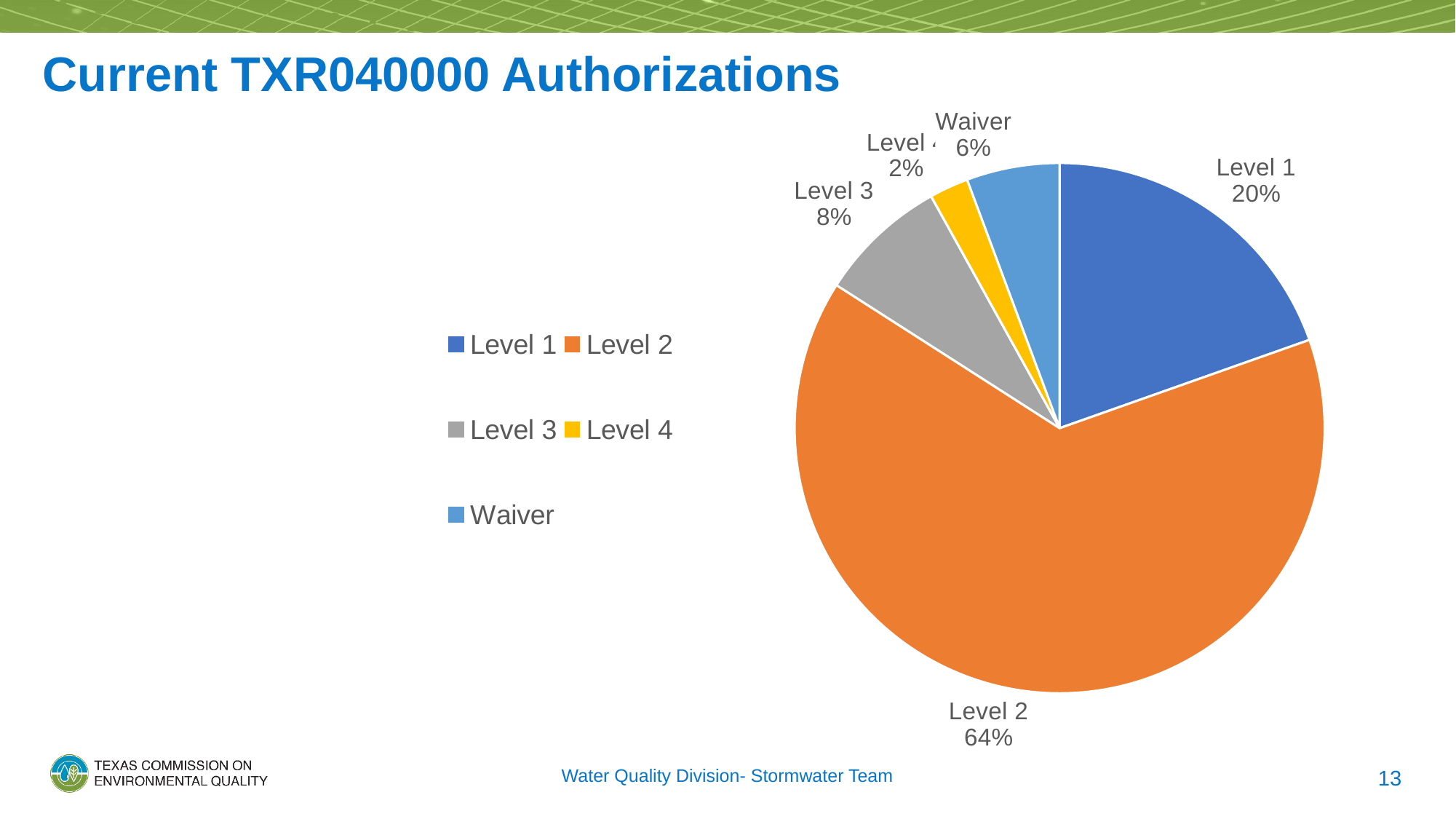
What percentage of authorizations is Level 2? 64% Which category has the smallest share of the pie? Level 4 What is the difference in percentage points between Level 2 and Level 1? 44 What is the title of the slide containing the chart? Current TXR040000 Authorizations What percentage of authorizations is Level 4? 2% What percentage of authorizations is Waiver? 6% Which is larger, the Level 3 share or the Waiver share? Level 3 What type of chart is shown on the slide? Pie chart What percentage of authorizations is Level 1? 20% What percentage of authorizations is Level 3? 8% How many categories are shown in the pie chart? 5 Which category has the largest share of the pie? Level 2